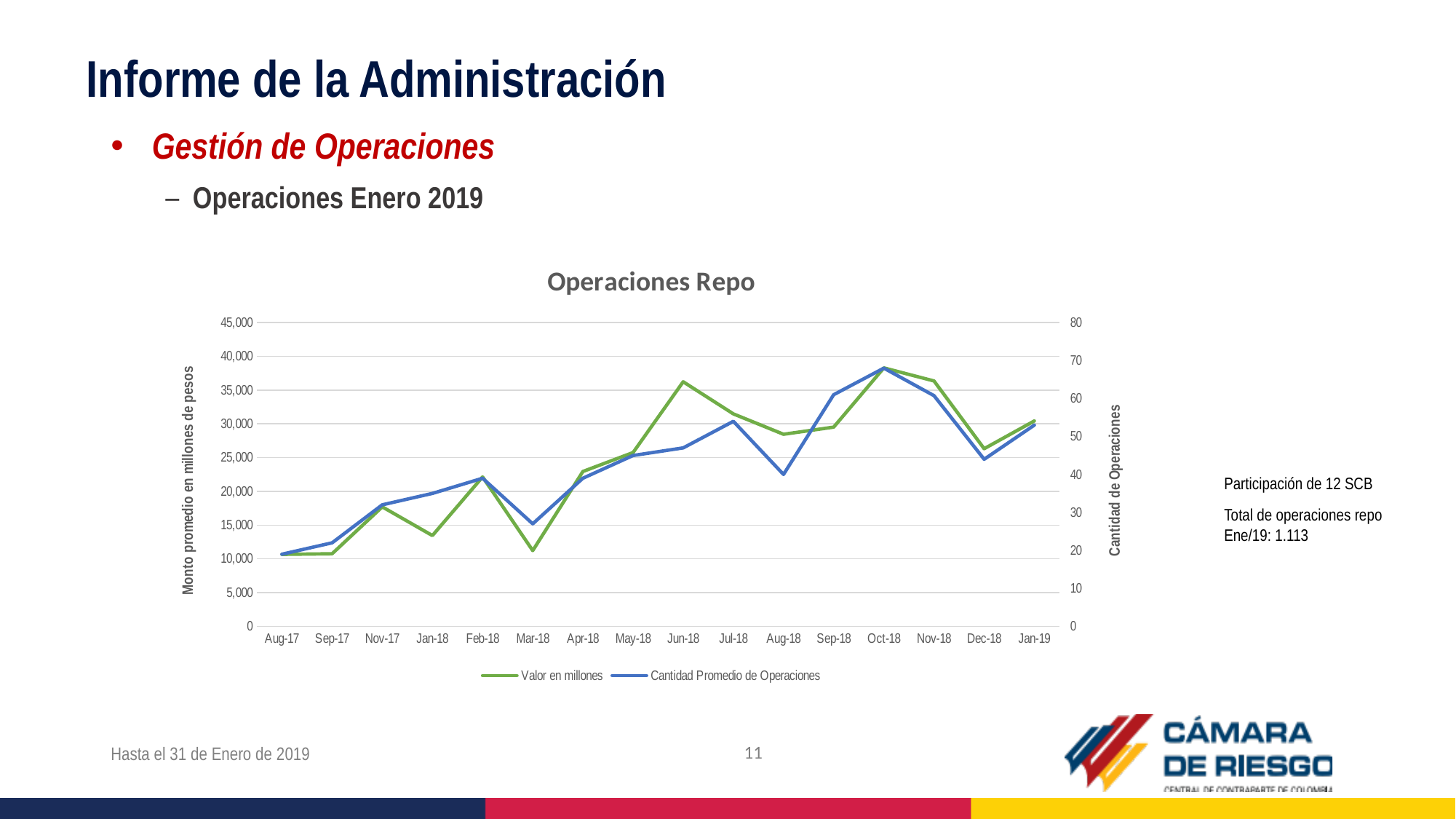
What is the title of the chart? Operaciones Repo Is the Cantidad Promedio de Operaciones value for Dec-18 greater or less than 50? less What kind of chart is shown on the slide? line chart In which month is the Cantidad Promedio de Operaciones series at its lowest? Aug-17 How many series does the chart legend list? 2 Which series is drawn in green in the chart? Valor en millones Which month has the higher Valor en millones, Jun-18 or Jul-18? Jun-18 Is the Valor en millones value for Mar-18 greater or less than 15,000? less In which month does the Valor en millones series reach its highest value? Oct-18 Is the Valor en millones value for Jun-18 greater or less than 30,000? greater In which month does the Cantidad Promedio de Operaciones series reach its highest value? Oct-18 How many months are plotted along the x axis of the chart? 16